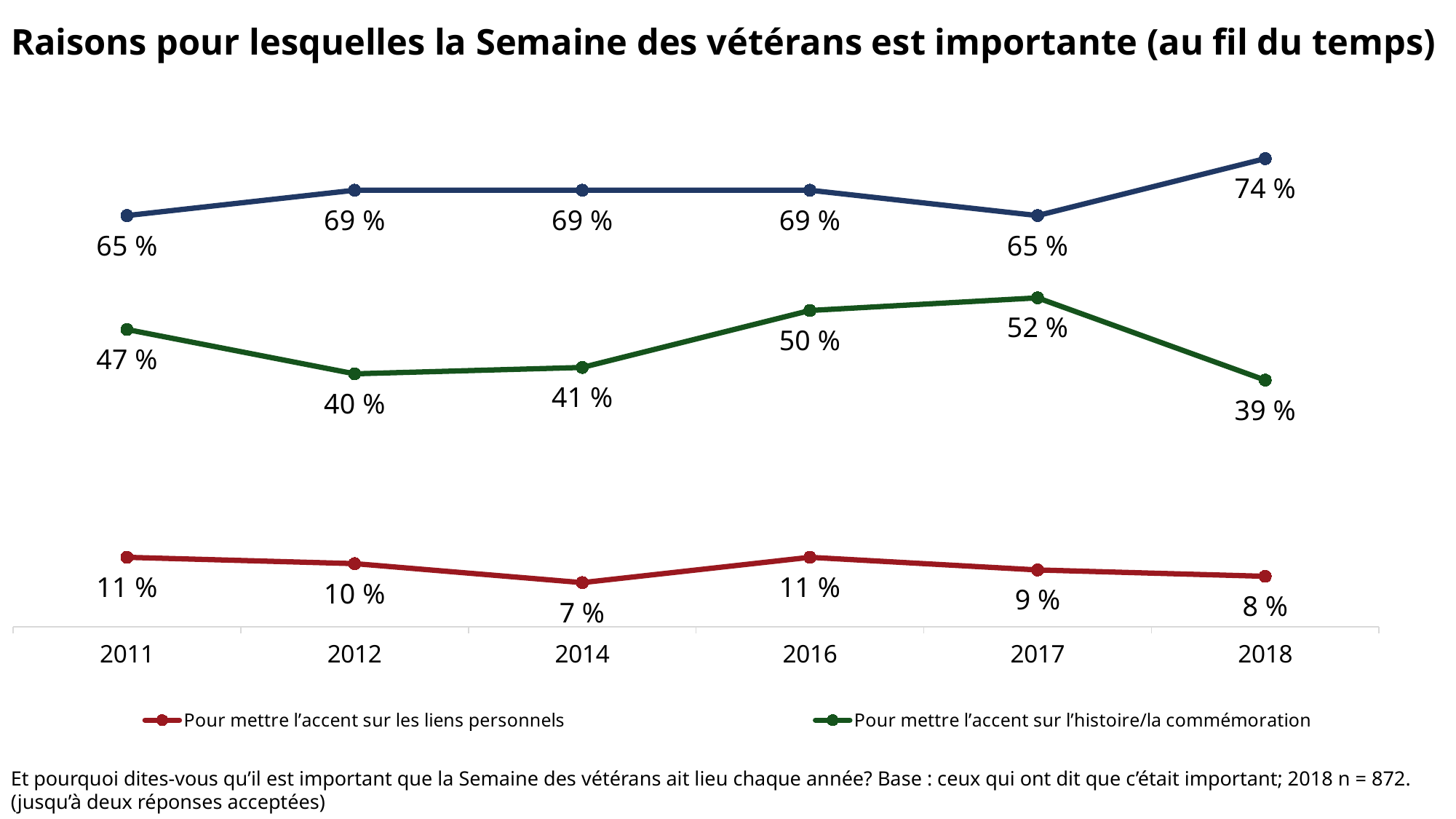
How many series does the legend list? 2 In which year is "Pour mettre l'accent sur les liens personnels" lowest? 2014 What is the value for "Pour mettre l'accent sur l'histoire/la commémoration" in 2016? 50 % How many years are shown on the x axis? 6 What is the value for "Pour mettre l'accent sur les liens personnels" in 2011? 11 % What is the value of the top (blue) line in 2018? 74 % For "Pour mettre l'accent sur l'histoire/la commémoration", which year has the larger value, 2011 or 2012? 2011 What is the value for "Pour mettre l'accent sur les liens personnels" in 2014? 7 % Does "Pour mettre l'accent sur les liens personnels" rise or fall from 2016 to 2018? fall What kind of chart is shown on the slide? line chart By how many percentage points did "Pour mettre l'accent sur l'histoire/la commémoration" fall from 2017 to 2018? 13 % In which year is "Pour mettre l'accent sur l'histoire/la commémoration" highest? 2017